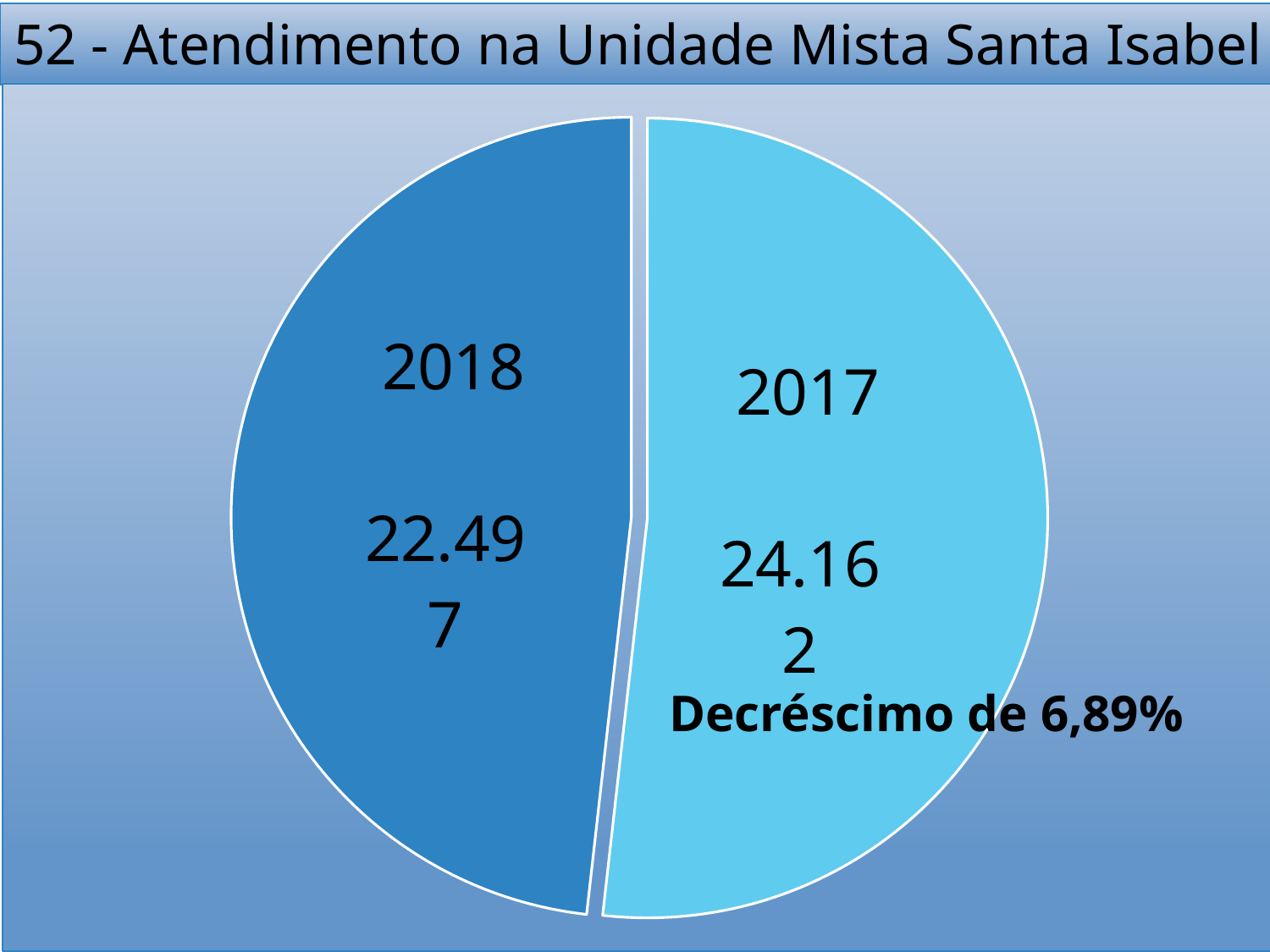
What is the value shown for 2017? 24.162 How many slices does the pie chart have? 2 Which year has the larger slice of the pie? 2017 Which year has the smaller slice of the pie? 2018 What is the title of the slide? 52 - Atendimento na Unidade Mista Santa Isabel What is the value shown for 2018? 22.497 What is the total of the two values shown in the pie chart? 46.659 Did the value fall or rise from 2017 to 2018? fall What percentage decrease is stated on the slide? 6,89% Is the value for 2017 larger or smaller than the value for 2018? larger What kind of chart is shown on the slide? pie chart What is the difference between the values for 2017 and 2018? 1.665